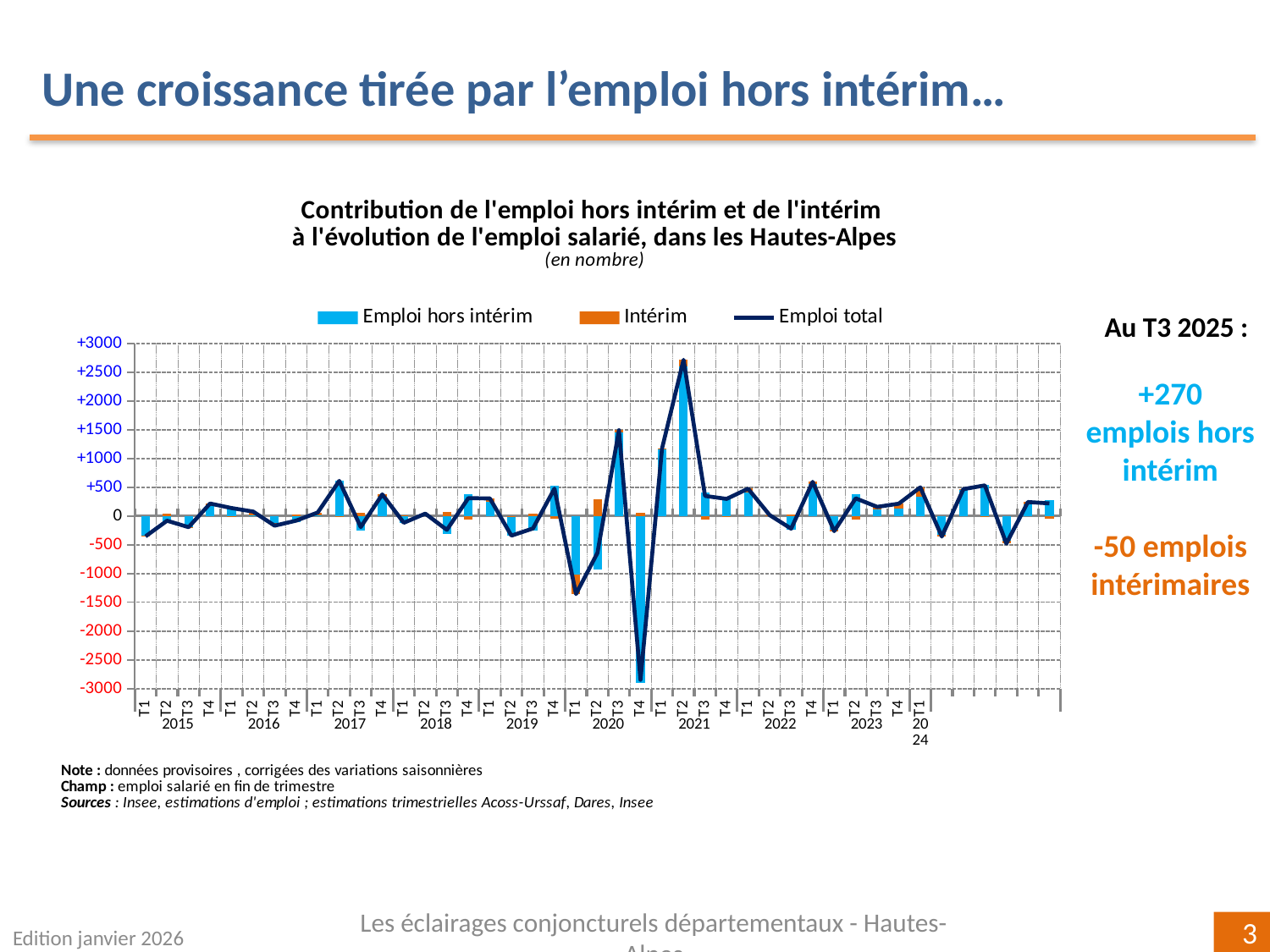
According to the slide, what is the value for Emploi hors intérim at T3 2025? +270 What kind of chart is shown on the slide? A combined bar and line chart According to the slide, what is the value for Intérim at T3 2025? -50 What unit is indicated under the chart title? en nombre In which quarter does the Emploi total line reach its highest value? T2 2021 Is the Emploi total value for T2 2021 greater or less than +2500? greater Is the Emploi total value for T4 2020 greater or less than -2500? less How many series does the chart legend list? 3 In which quarter does the Emploi total line reach its lowest value? T4 2020 Which quarter has the higher Emploi total value, T3 2020 or T2 2021? T2 2021 Which series is drawn as a line rather than bars? Emploi total Is the Emploi total value for T1 2020 greater or less than -1000? less